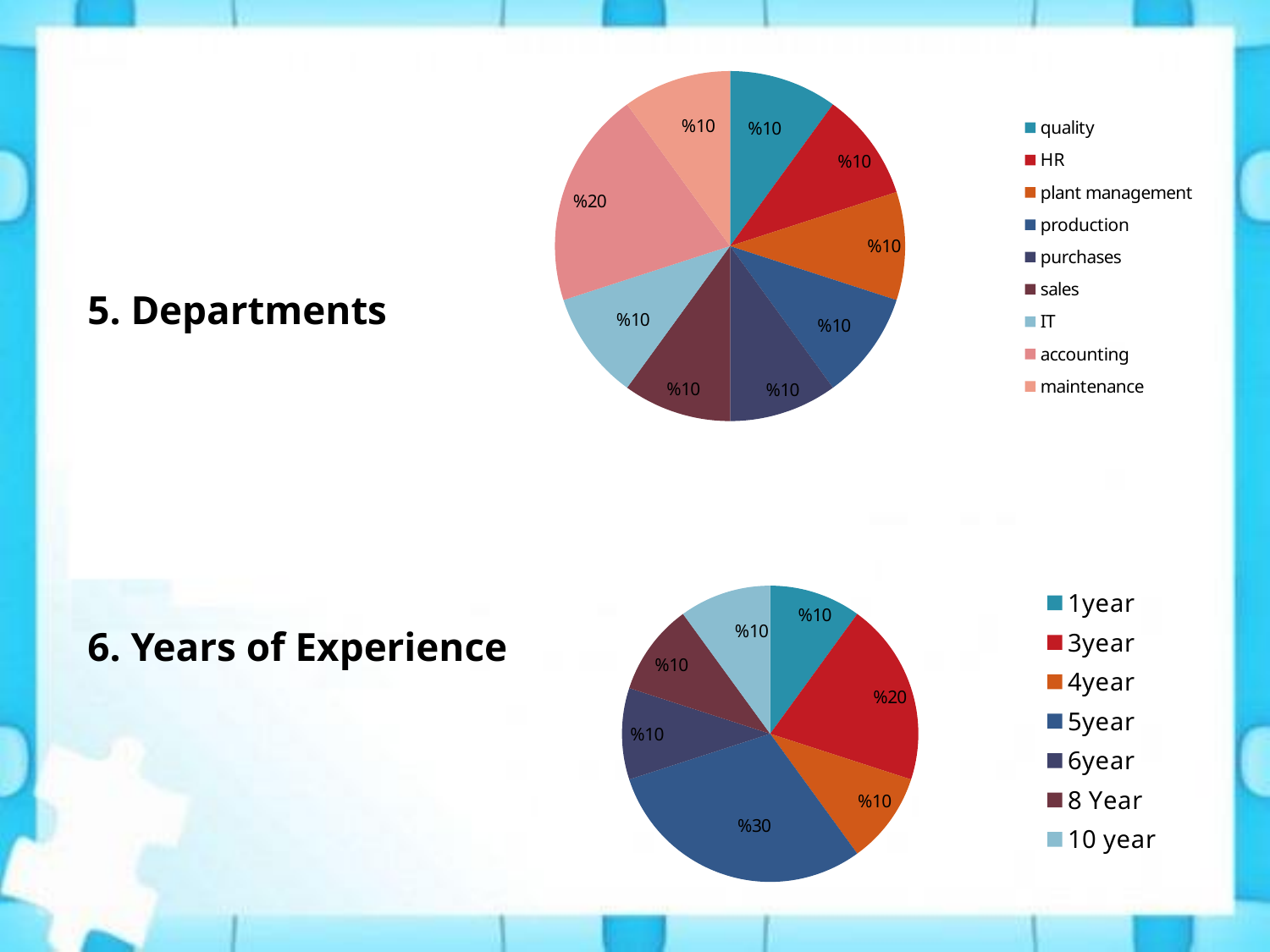
In the Years of Experience pie chart, what is the difference between the 5year share and the 3year share? %10 In the Departments pie chart, what share does accounting have? %20 In the Years of Experience pie chart, which category has the largest share? 5year What kind of chart is the Years of Experience chart? pie chart In the Years of Experience pie chart, what share does 5year have? %30 How many entries does the legend of the Years of Experience pie chart list? 7 In the Departments pie chart, what share does IT have? %10 In the Years of Experience pie chart, which is larger, the share for 3year or the share for 10 year? 3year How many slices does the Departments pie chart have? 9 In the Departments pie chart, which department has the largest share? accounting In the Departments pie chart, what is the difference between the accounting share and the HR share? %10 In the Years of Experience pie chart, what share does 3year have? %20